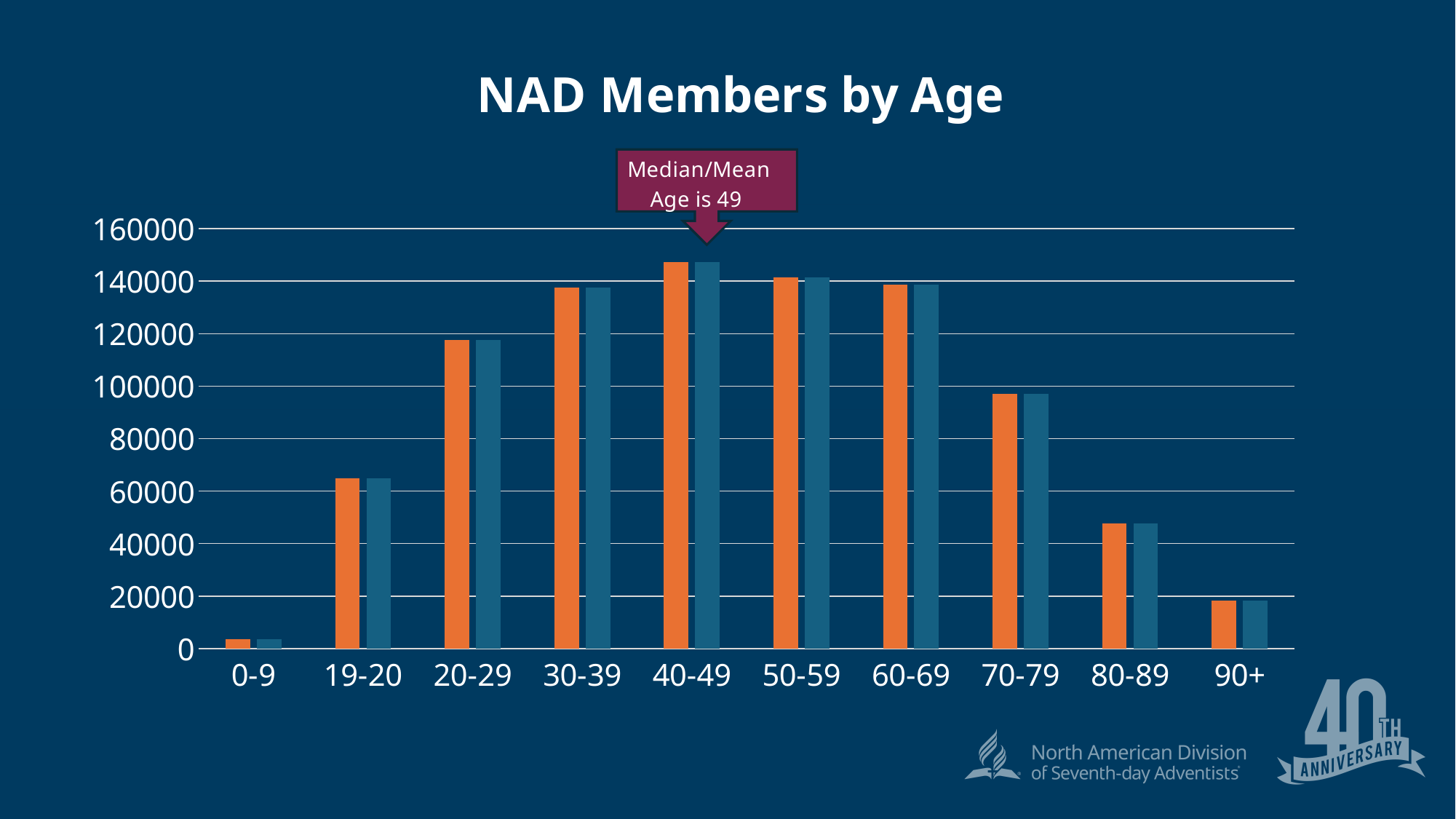
Is the value for the 19-20 age group greater or less than 60000? greater Is the value for the 40-49 age group greater or less than 140000? greater Is the value for the 90+ age group greater or less than 40000? less Which age group has more members, 20-29 or 30-39? 30-39 Do the values rise or fall along the x axis from the 40-49 group to the 90+ group? fall What is the title of the chart? NAD Members by Age Which age group has the lowest number of members? 0-9 How many age categories are shown on the x axis? 10 What kind of chart is shown on the slide? bar chart Which age group has the highest number of members? 40-49